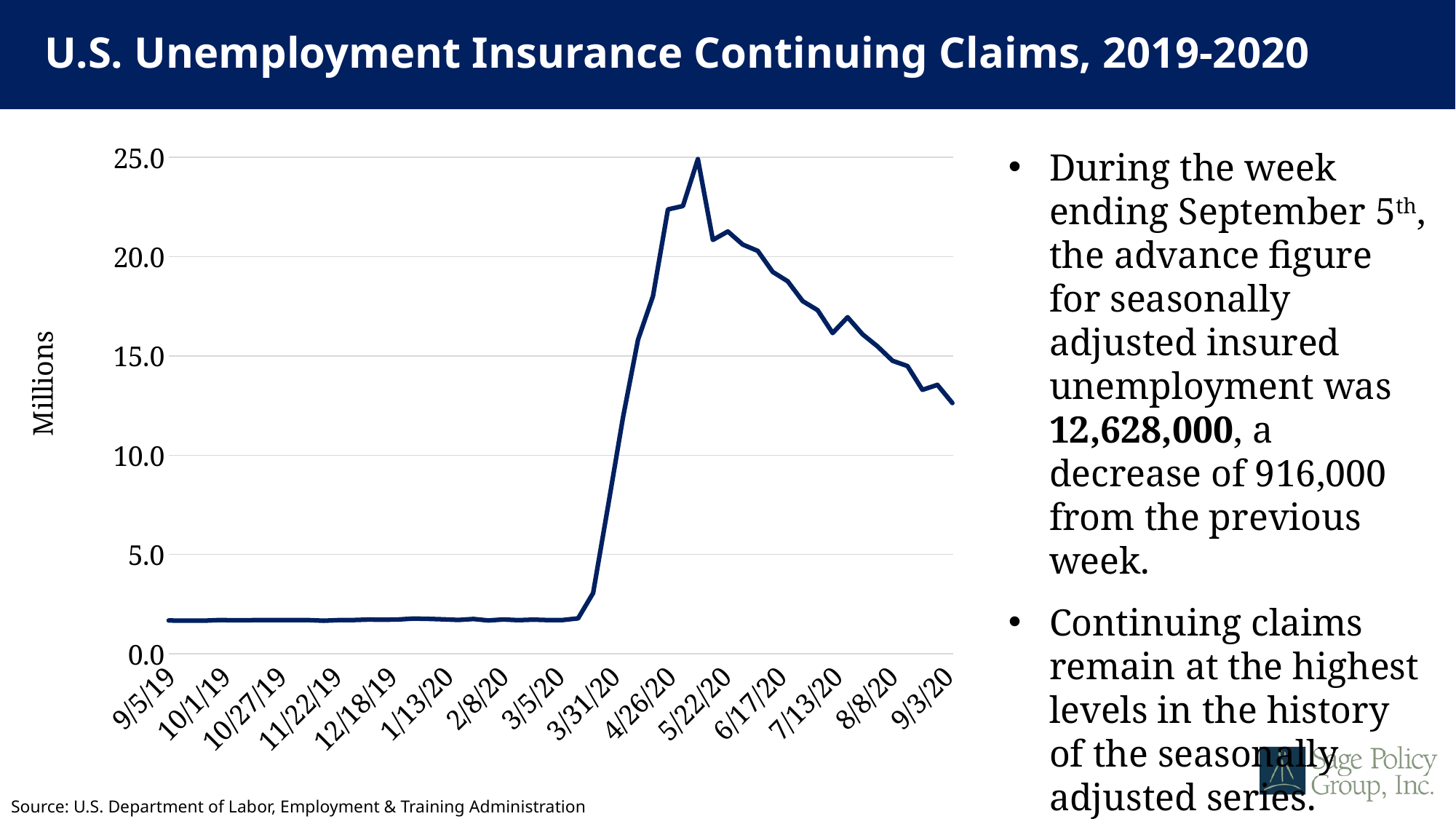
Is the highest value on the line greater or less than 20.0? greater Is the value for 9/3/20 greater or less than 15.0? less How many date labels are shown along the x axis? 15 Do the values rise or fall between 5/22/20 and 9/3/20? fall Is the value for 7/13/20 greater or less than 15.0? greater What kind of chart is shown on the slide? line chart What is the label on the vertical axis of the chart? Millions Which is larger, the value for 9/5/19 or the value for 9/3/20? 9/3/20 What is the title of the chart? U.S. Unemployment Insurance Continuing Claims, 2019-2020